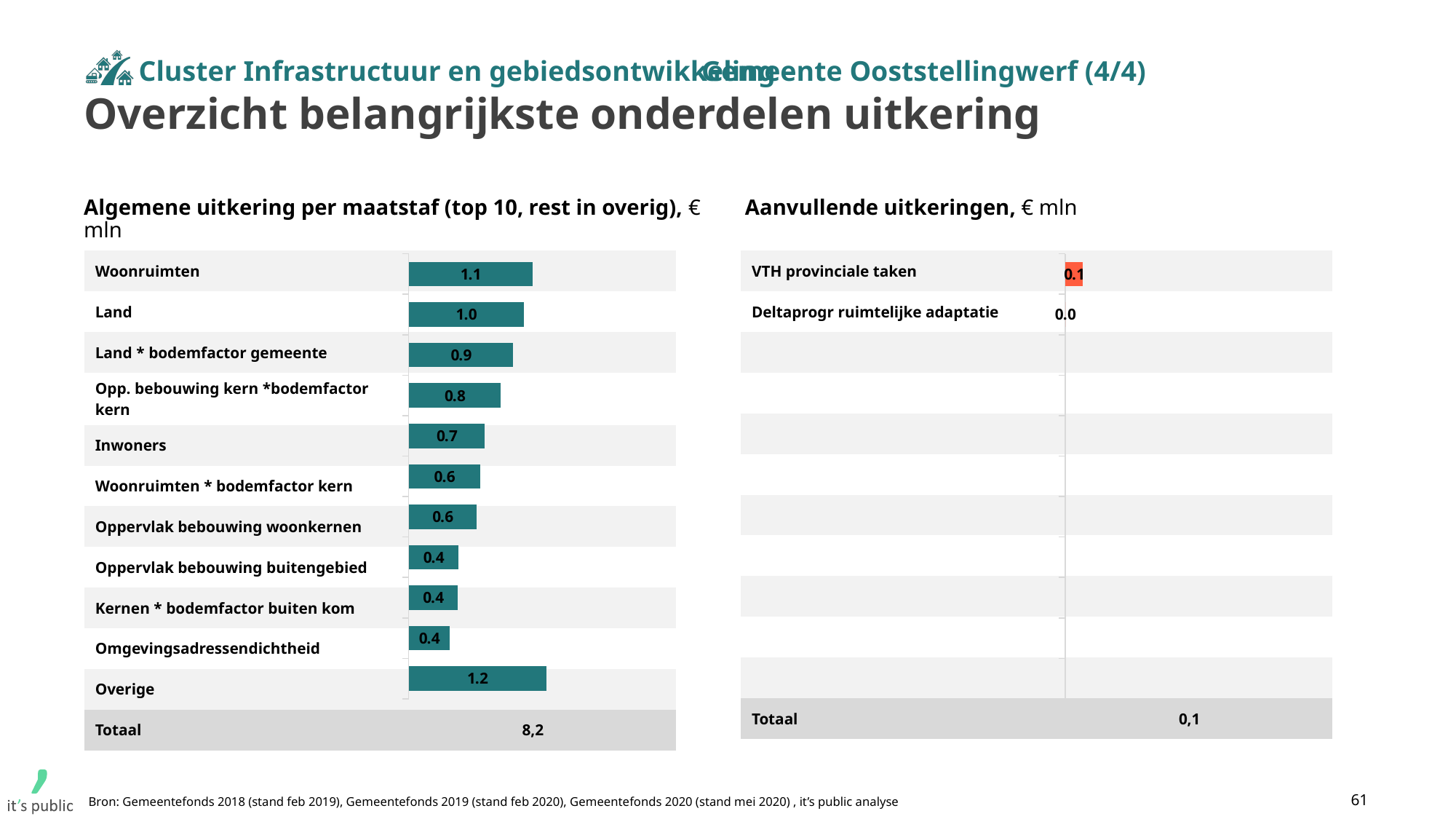
In the chart 'Algemene uitkering per maatstaf', what is the value for Inwoners? 0.7 In the chart 'Algemene uitkering per maatstaf', what is the difference between Woonruimten and Land * bodemfactor gemeente? 0.2 In the chart 'Aanvullende uitkeringen', what is the value for VTH provinciale taken? 0.1 In the chart 'Aanvullende uitkeringen', which category has the lowest value? Deltaprogr ruimtelijke adaptatie In the chart 'Algemene uitkering per maatstaf', what is the value for Woonruimten? 1.1 What kind of chart is 'Algemene uitkering per maatstaf'? Bar chart In the chart 'Algemene uitkering per maatstaf', which is larger: Land or Oppervlak bebouwing buitengebied? Land How many bars are shown in the chart 'Algemene uitkering per maatstaf'? 11 What unit is stated in the title of the chart 'Aanvullende uitkeringen'? € mln In the chart 'Algemene uitkering per maatstaf', what is the value for Omgevingsadressendichtheid? 0.4 In the chart 'Algemene uitkering per maatstaf', which category has the highest value? Overige What is the total shown for the chart 'Algemene uitkering per maatstaf'? 8,2